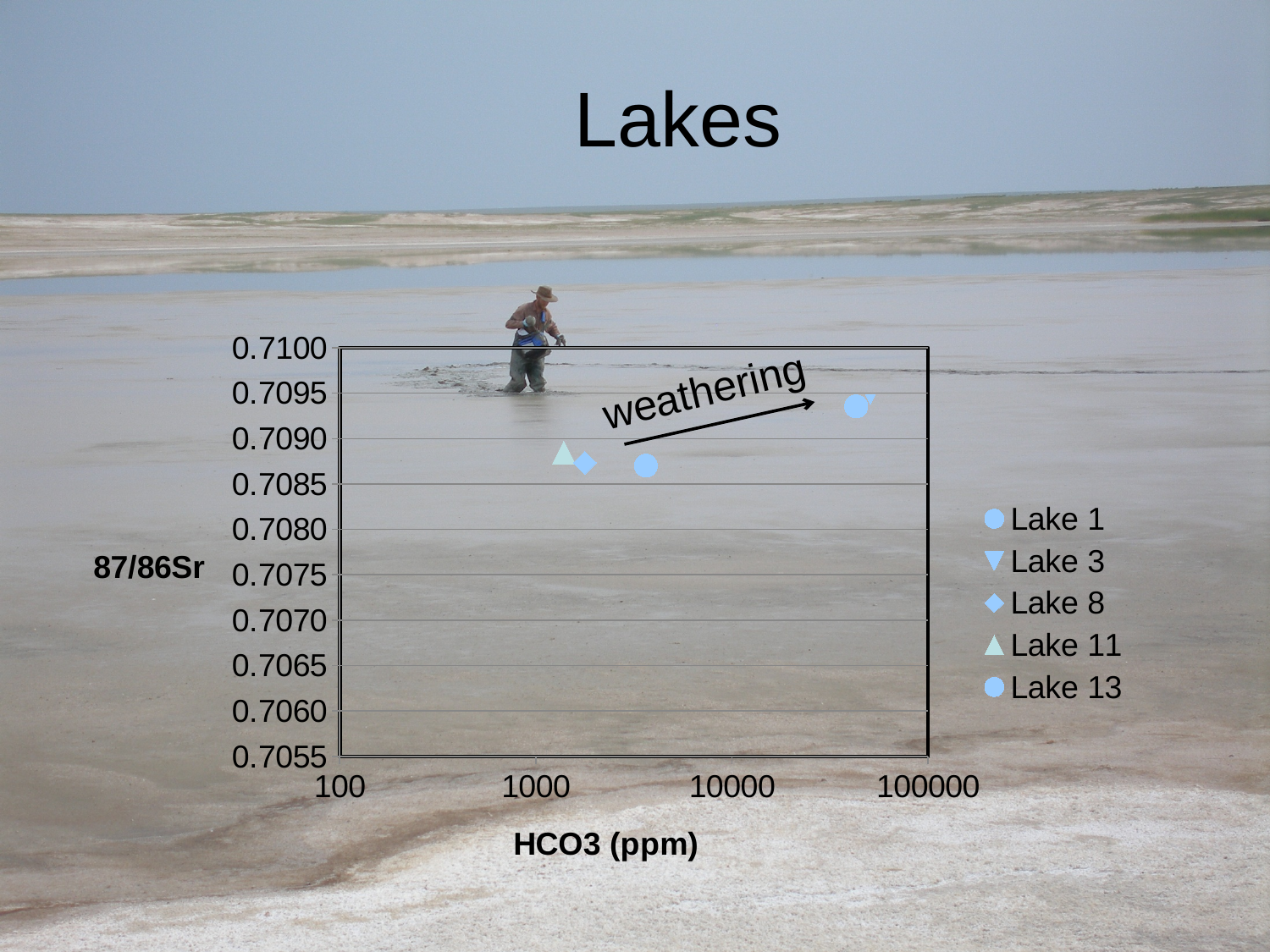
What is the label on the x axis of the chart? HCO3 (ppm) What kind of chart is shown on the slide? scatter chart Is the 87/86Sr value for Lake 8 greater or less than 0.7090? less Do the 87/86Sr values generally rise or fall as HCO3 (ppm) increases along the x axis? rise Is the HCO3 (ppm) value for Lake 11 greater or less than 10000? less How many series does the legend list? 5 How many data points are plotted on the chart? 5 What word is written along the arrow annotation on the chart? weathering Is the HCO3 (ppm) value for Lake 3 greater or less than 10000? greater